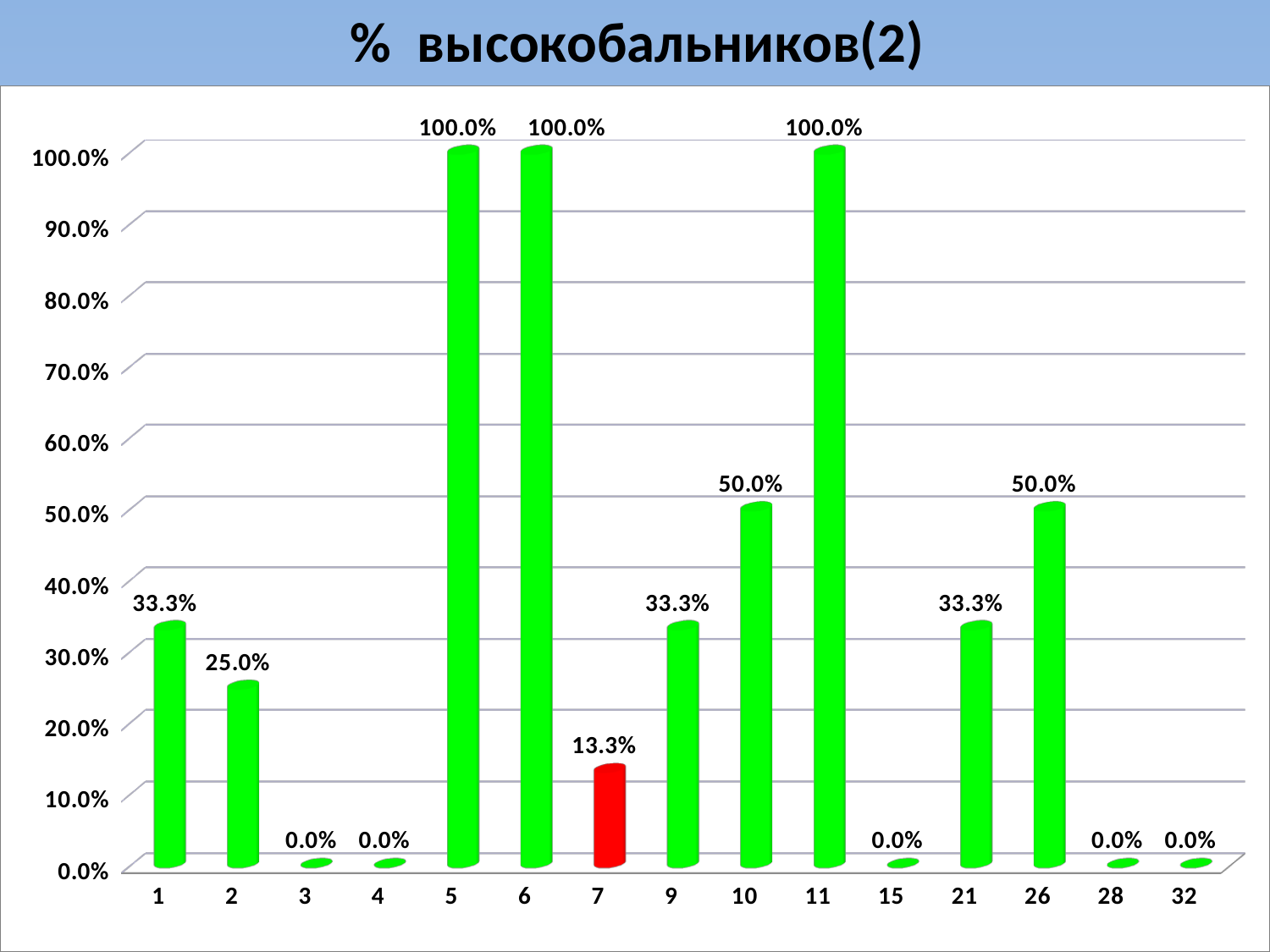
What is the difference between the values for category 10 and category 7? 36.7% What is the value for category 26? 50.0% What kind of chart is shown on the slide? bar chart What is the value for category 15? 0.0% What is the value for category 7? 13.3% Which is larger, the value for category 9 or the value for category 10? category 10 What is the value for category 21? 33.3% What is the value for category 2? 25.0% Is the value for category 7 greater or less than 20.0%? less How many categories are shown on the x axis? 15 What is the difference between the values for category 1 and category 2? 8.3% Which category's bar is coloured red? 7